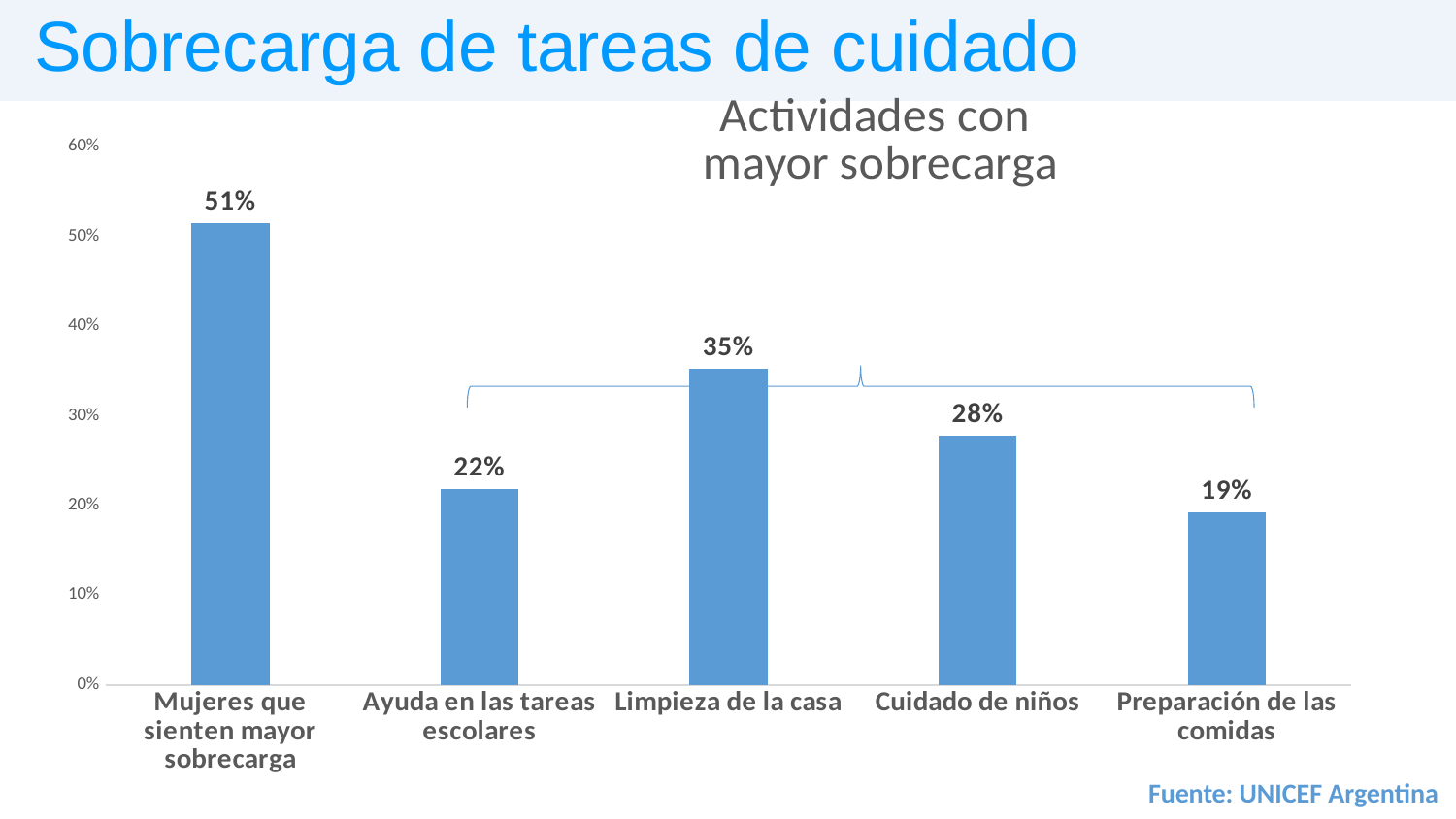
How many categories are shown on the chart? 5 What is the value for "Limpieza de la casa"? 35% What is the value for "Cuidado de niños"? 28% What is the title of the chart? Actividades con mayor sobrecarga Is the value for "Cuidado de niños" greater or less than 30%? less What kind of chart is shown on the slide? Bar chart What is the value for "Mujeres que sienten mayor sobrecarga"? 51% Which category has the highest value? Mujeres que sienten mayor sobrecarga Which category has the lowest value? Preparación de las comidas What is the difference between the values for "Limpieza de la casa" and "Ayuda en las tareas escolares"? 13% What is the value for "Preparación de las comidas"? 19% Which is larger, the value for "Cuidado de niños" or the value for "Ayuda en las tareas escolares"? Cuidado de niños